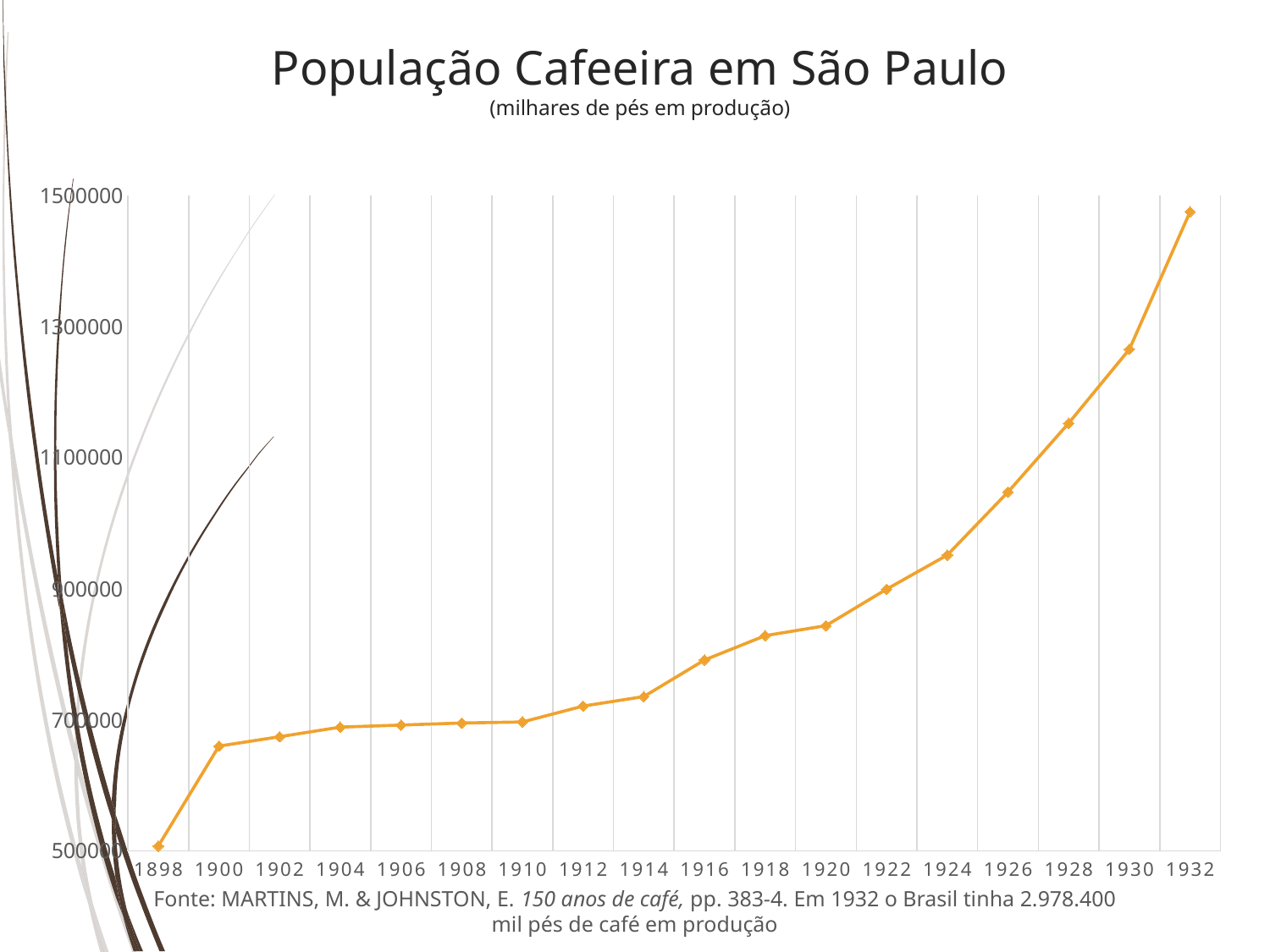
Which year has the highest value? 1932 Is the value for 1932 greater or less than 1300000? greater Is the value for 1916 greater or less than 900000? less Do the values generally rise or fall from 1898 to 1932? rise Which year has the lowest value? 1898 Is the value for 1926 greater or less than 900000? greater What is the title of the chart? População Cafeeira em São Paulo Which year has the larger value, 1926 or 1916? 1926 How many years (data points) are plotted on the x axis? 18 What unit does the chart's subtitle say the values are in? milhares de pés em produção What kind of chart is shown on the slide? line chart